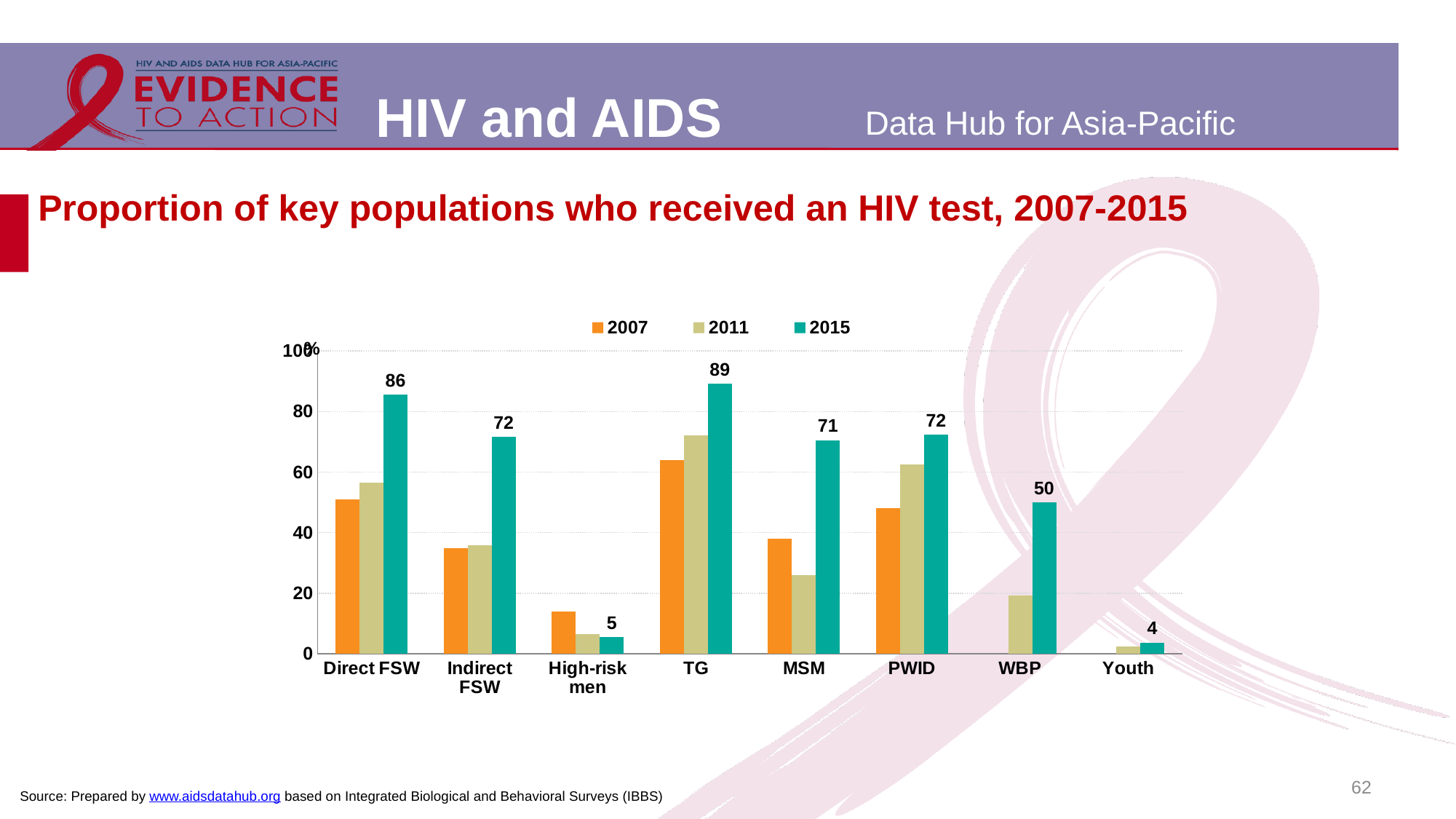
How many key population categories are shown on the x axis? 8 What is the 2015 value for WBP? 50 Is the 2011 value for MSM greater or less than 40? less Is the 2007 value for Direct FSW greater or less than 40? greater Which is larger, the 2015 value for Indirect FSW or the 2015 value for WBP? Indirect FSW What is the 2015 value for TG? 89 Which key population has the highest 2015 value? TG How many series does the legend list? 3 What is the 2015 value for Direct FSW? 86 Which key population has the lowest 2015 value? Youth What is the 2015 value for Youth? 4 What is the difference between the 2015 values for TG and MSM? 18